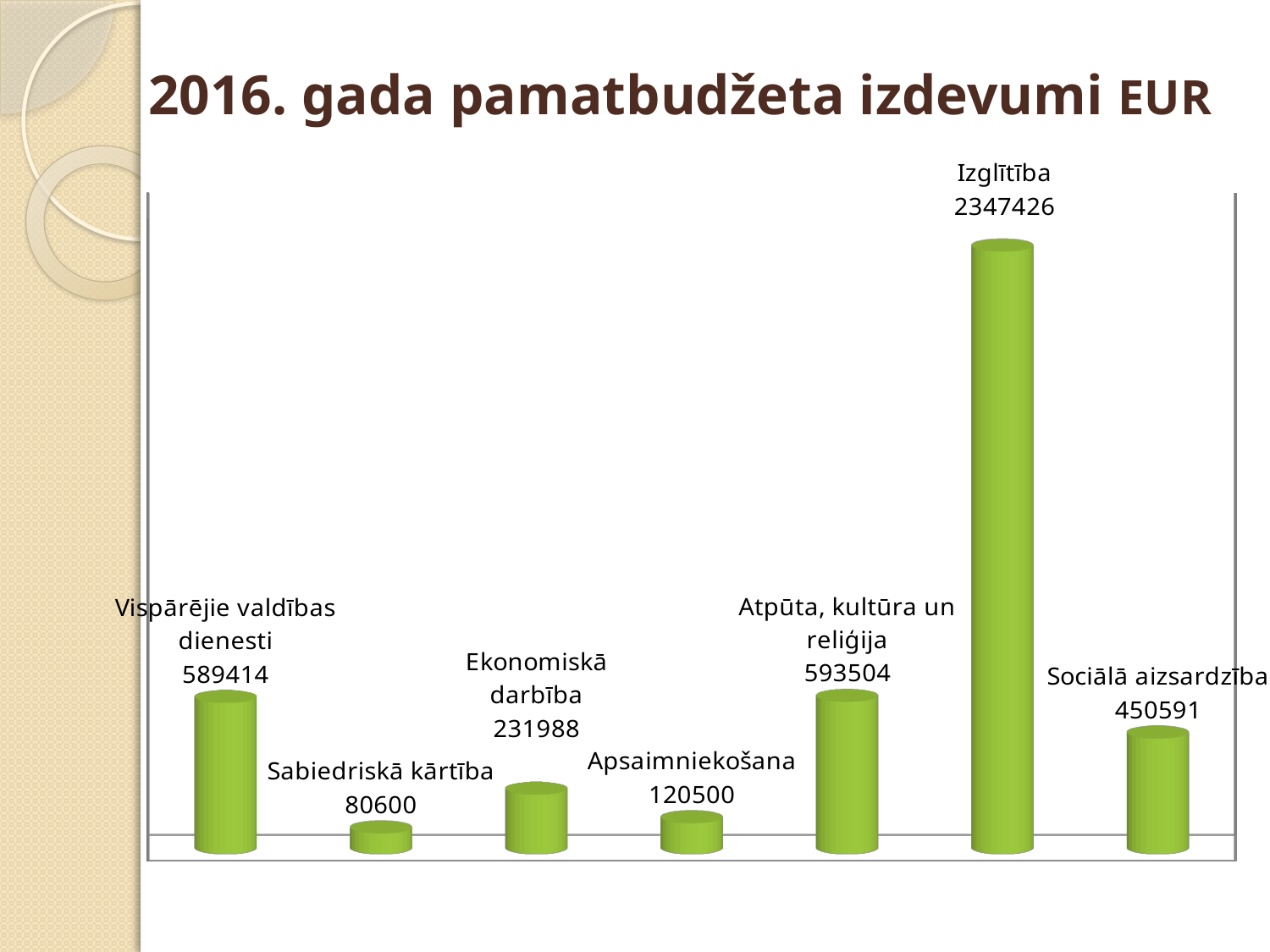
What kind of chart is shown on the slide? Bar chart What is the value for Apsaimniekošana? 120500 What is the value for Sociālā aizsardzība? 450591 How many categories are shown in the chart? 7 What is the difference between the values for Ekonomiskā darbība and Apsaimniekošana? 111488 What is the value for Izglītība? 2347426 Which is larger, the value for Atpūta, kultūra un reliģija or the value for Vispārējie valdības dienesti? Atpūta, kultūra un reliģija What is the difference between the values for Izglītība and Sociālā aizsardzība? 1896835 Which category has the highest value? Izglītība What is the value for Sabiedriskā kārtība? 80600 What is the title of the slide? 2016. gada pamatbudžeta izdevumi EUR Which category has the lowest value? Sabiedriskā kārtība